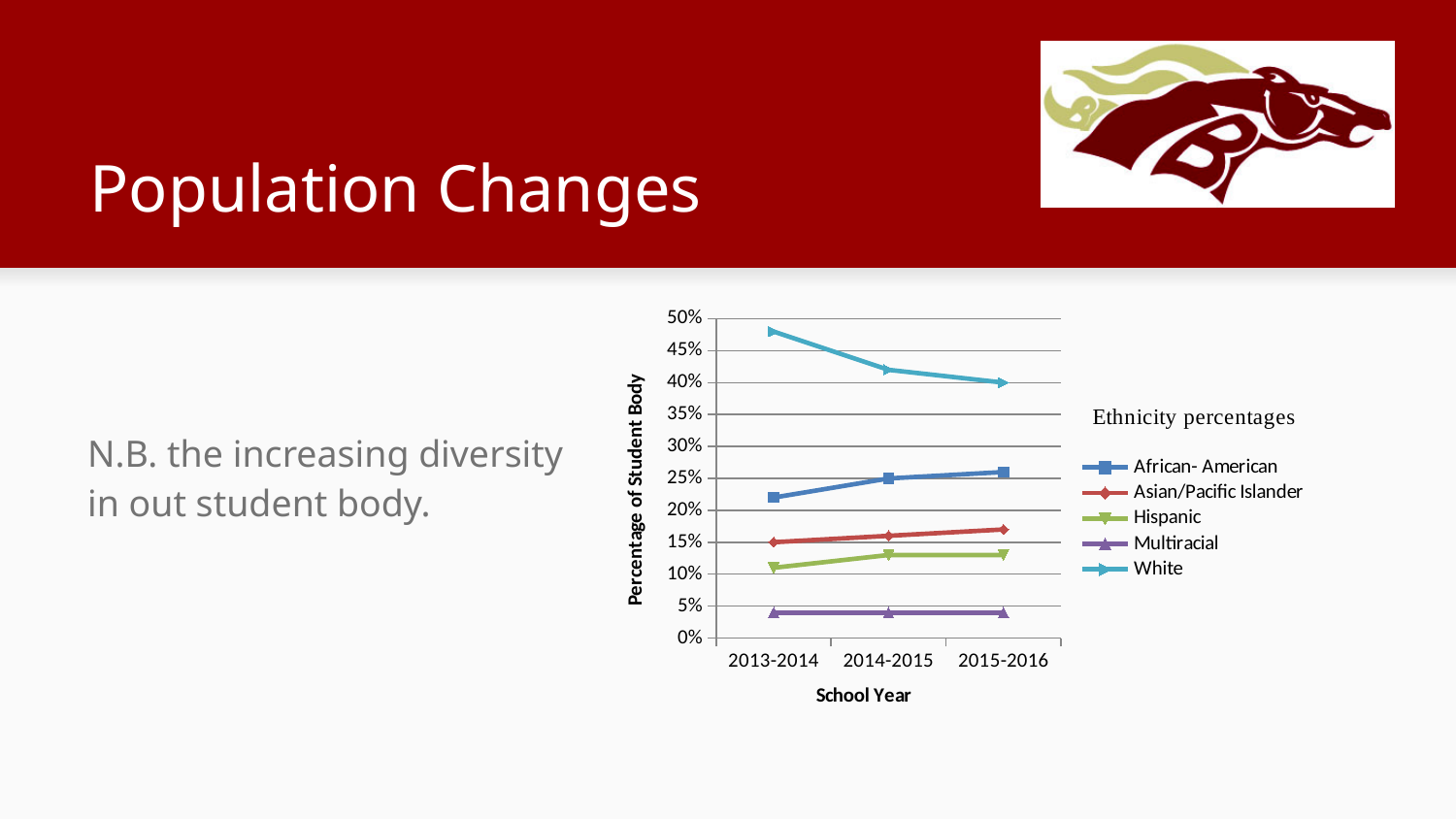
What kind of chart is shown on the slide? line chart Does the African- American percentage rise or fall from 2013-2014 to 2015-2016? rise Which ethnicity has the highest percentage in 2013-2014? White How many school years are plotted on the x axis? 3 Is the Multiracial percentage in 2014-2015 greater or less than 5%? less Is the White percentage in 2013-2014 greater or less than 45%? greater What is the title of the chart's legend? Ethnicity percentages In 2015-2016, which is larger: the Asian/Pacific Islander percentage or the Hispanic percentage? Asian/Pacific Islander How many series does the legend list? 5 Does the White percentage rise or fall from 2013-2014 to 2015-2016? fall Is the Hispanic percentage in 2013-2014 greater or less than 15%? less Which ethnicity has the lowest percentage in 2015-2016? Multiracial